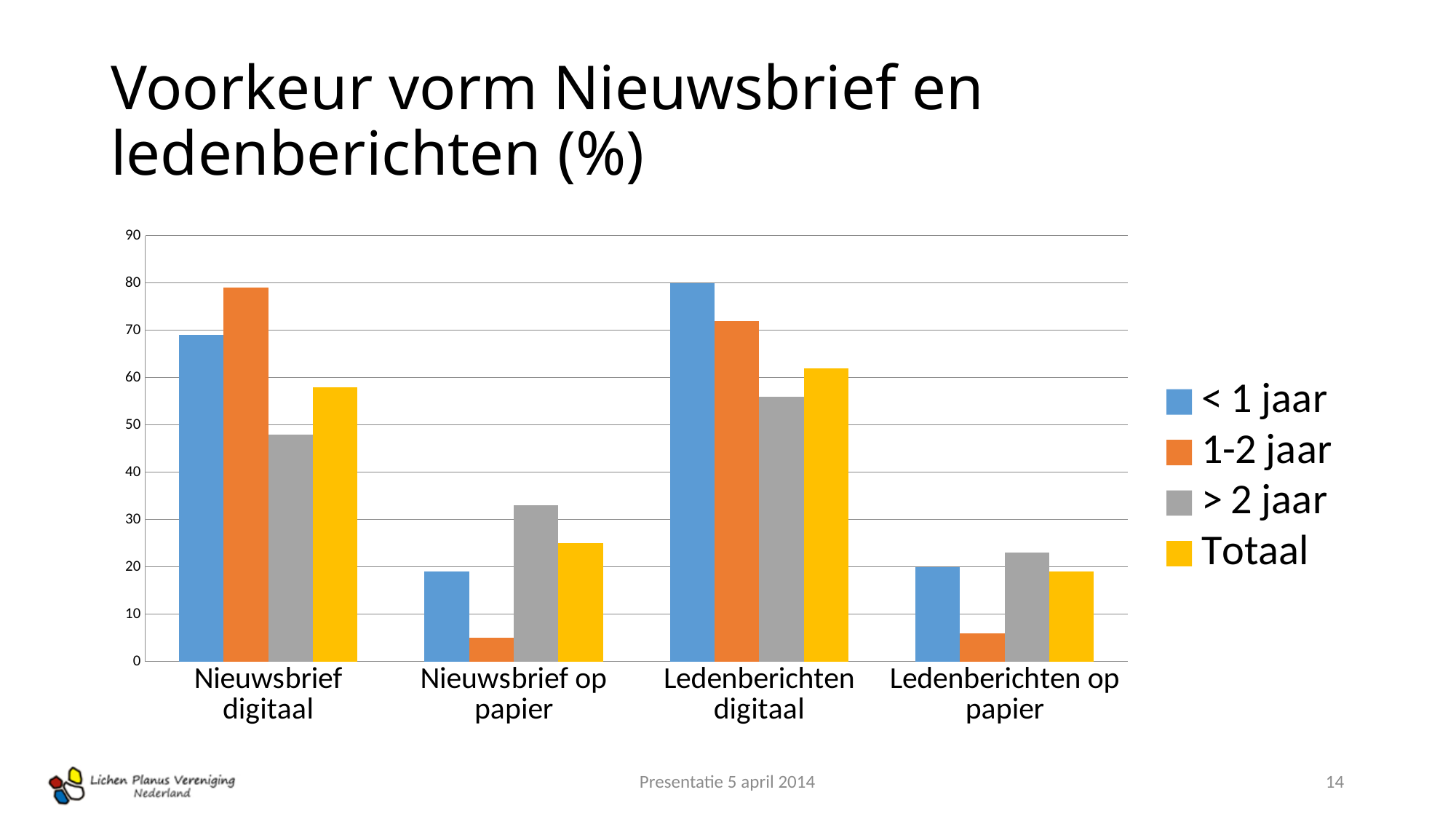
How many series does the legend list? 4 How many categories are shown on the x axis? 4 What kind of chart is shown on the slide? bar chart Which is larger for > 2 jaar: Nieuwsbrief digitaal or Ledenberichten digitaal? Ledenberichten digitaal Is the value for 1-2 jaar in Nieuwsbrief digitaal greater or less than 70? greater Is the value for > 2 jaar in Nieuwsbrief op papier greater or less than 30? greater Which series has the highest value for Nieuwsbrief digitaal? 1-2 jaar Which series has the lowest value for Nieuwsbrief op papier? 1-2 jaar Which colour represents the Totaal series in the legend? yellow What is the value for < 1 jaar in Ledenberichten digitaal? 80 Which series has the highest value for Ledenberichten digitaal? < 1 jaar Which series has the lowest value for Ledenberichten op papier? 1-2 jaar